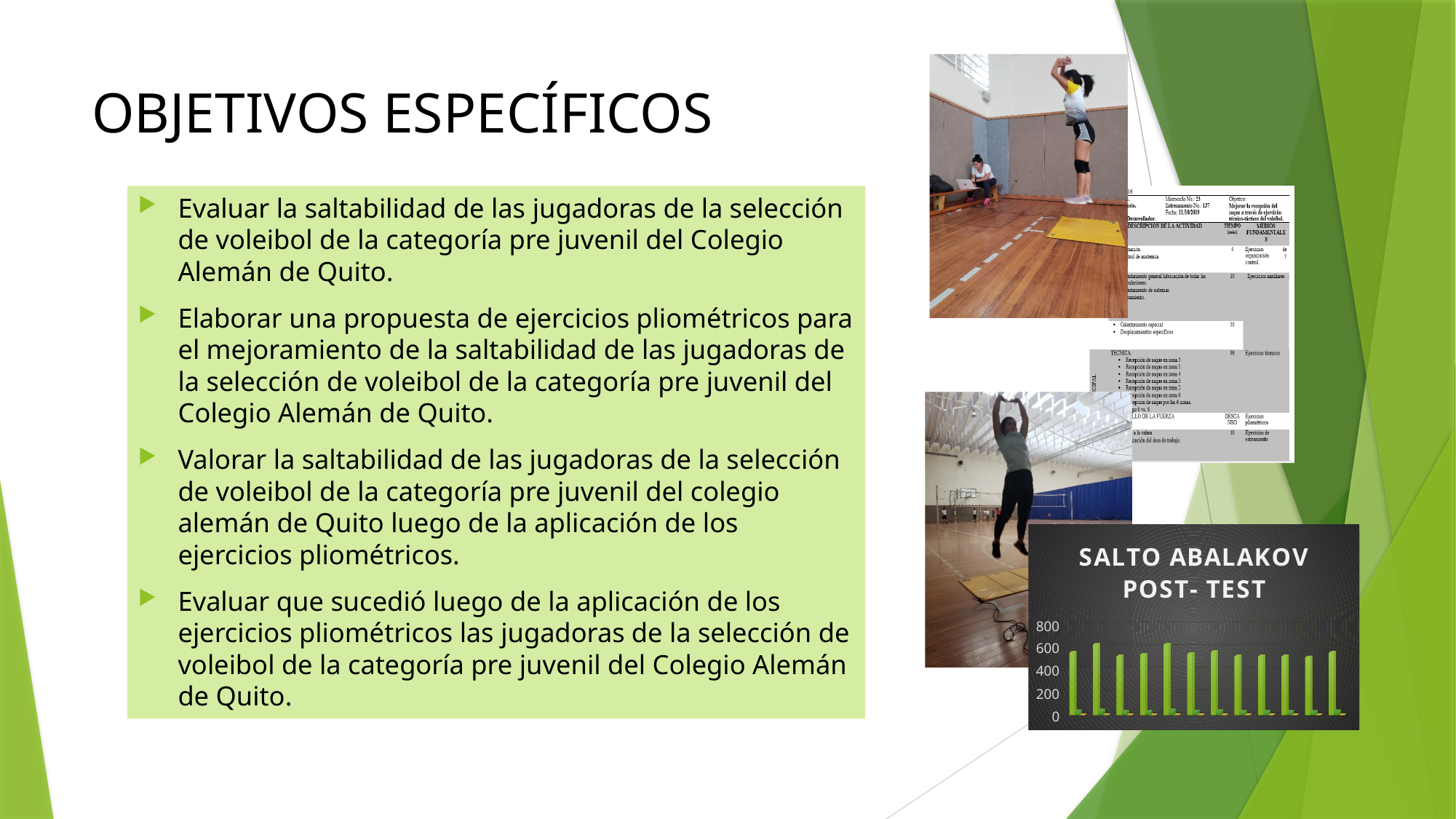
Is the tallest bar in the chart greater or less than 400? greater What kind of chart is shown on the slide? bar chart Is the shortest bar in the chart greater or less than 200? less How many bars are plotted in the chart? 36 What is the highest value shown on the vertical axis of the chart? 800 What is the title of the chart on the slide? SALTO ABALAKOV POST- TEST Is the tallest bar in the chart greater or less than 800? less